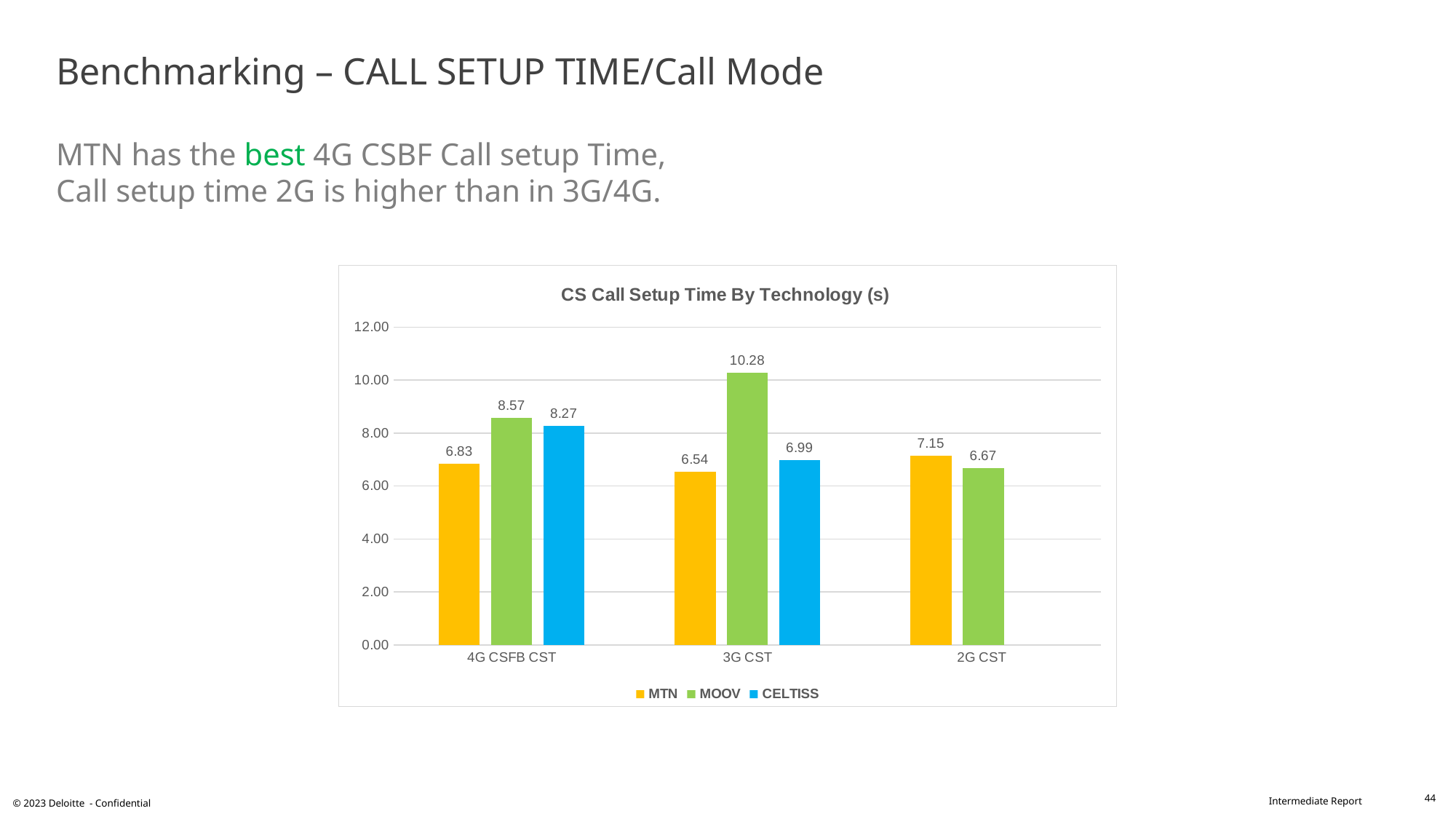
Which operator has the lowest call setup time in the 4G CSFB CST category? MTN What kind of chart is shown on the slide? Bar chart Which operator has the highest call setup time in the 3G CST category? MOOV What is the CS call setup time for MTN in the 4G CSFB CST category? 6.83 What is the title of the chart? CS Call Setup Time By Technology (s) How many series does the legend list? 3 What is the CS call setup time for MOOV in the 3G CST category? 10.28 What is the CS call setup time for CELTISS in the 4G CSFB CST category? 8.27 What is the CS call setup time for MOOV in the 2G CST category? 6.67 What is the difference between MOOV's and MTN's call setup time in the 3G CST category? 3.74 Which is larger: MTN's call setup time for 2G CST or MOOV's call setup time for 2G CST? MTN How many technology categories are shown on the x axis? 3